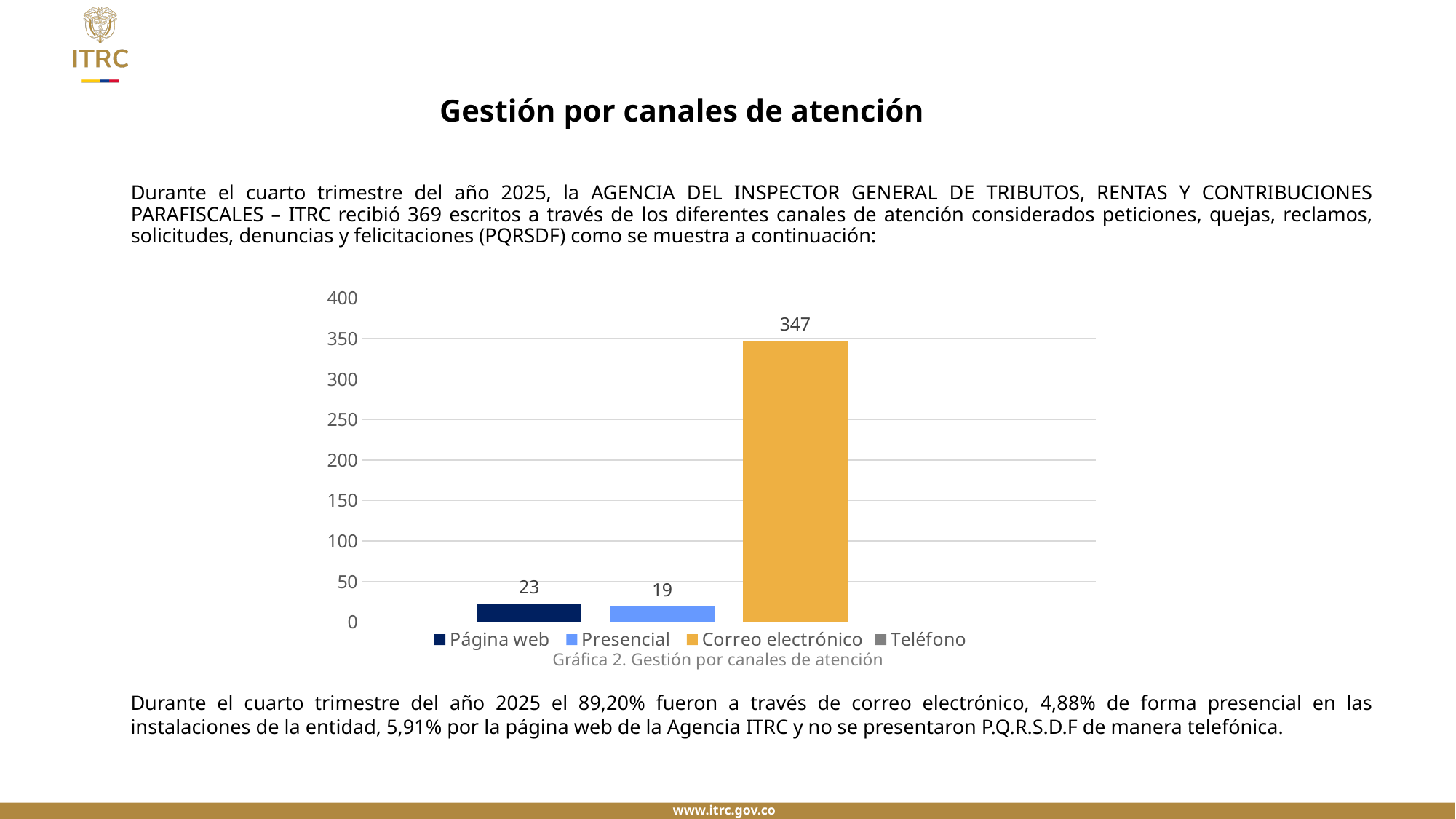
Is the value for Correo electrónico greater or less than 300? greater Which of the labelled bars has the lowest value? Presencial What is the difference between the values for Correo electrónico and Página web? 324 What value is shown for Correo electrónico? 347 Which is larger, the value for Página web or the value for Presencial? Página web Which channel has the highest value in the chart? Correo electrónico What value is shown for Página web? 23 What is the caption shown below the chart? Gráfica 2. Gestión por canales de atención What value is shown for Presencial? 19 What kind of chart is shown on the slide? Bar chart What is the difference between the values for Página web and Presencial? 4 How many series does the legend list? 4